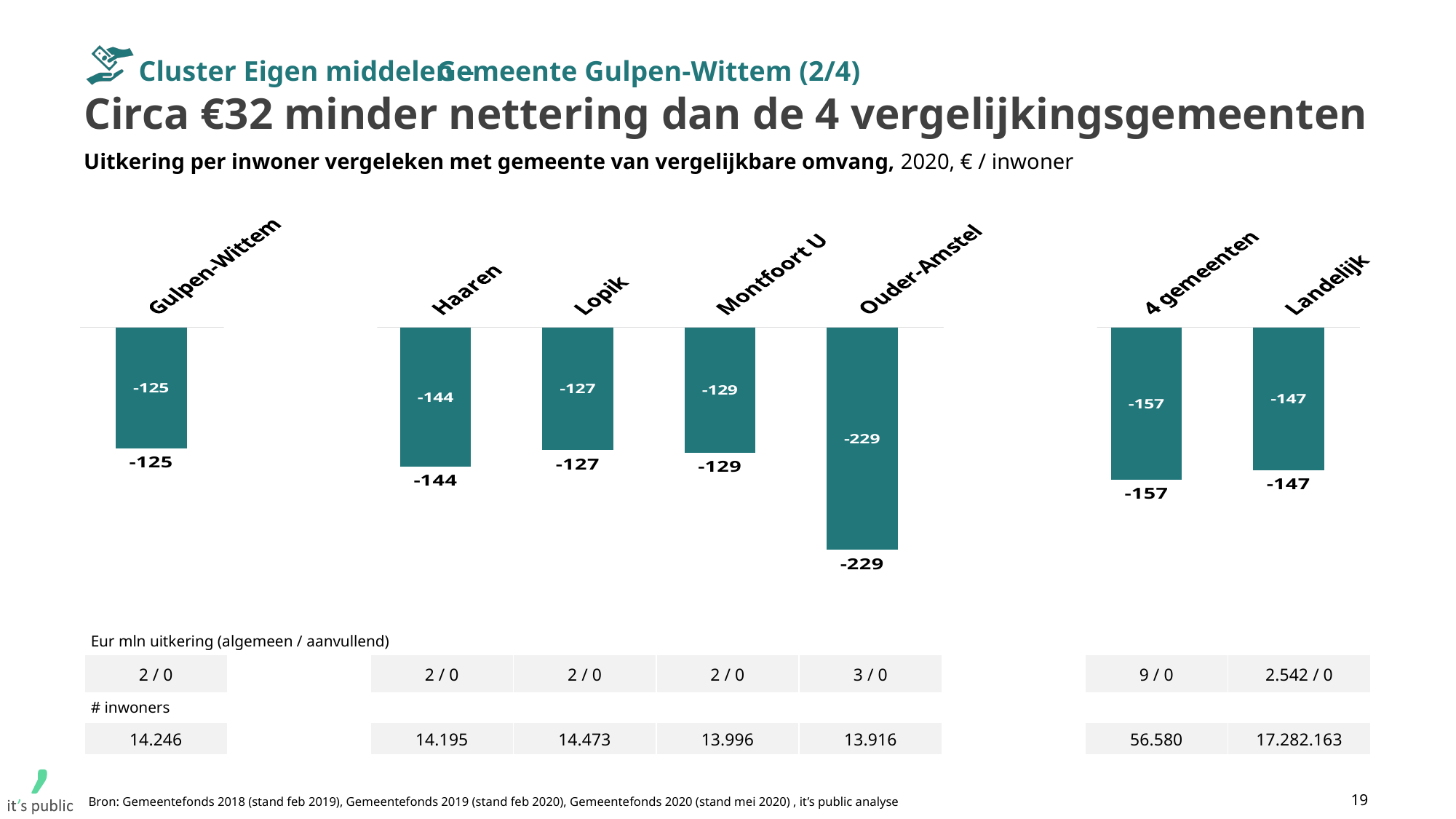
Which has the larger (less negative) value, Haaren or Lopik? Lopik What is the value for Landelijk? -147 What is the difference between the values for Gulpen-Wittem and 4 gemeenten? 32 How many bars are shown in the chart? 7 What is the value for Montfoort U? -129 What is the value for Gulpen-Wittem? -125 What is the value for 4 gemeenten? -157 What is the value for Ouder-Amstel? -229 Which category has the highest (least negative) value? Gulpen-Wittem What is the difference between the values for Ouder-Amstel and Landelijk? 82 What kind of chart is shown on the slide? Bar chart Which category has the lowest (most negative) value? Ouder-Amstel